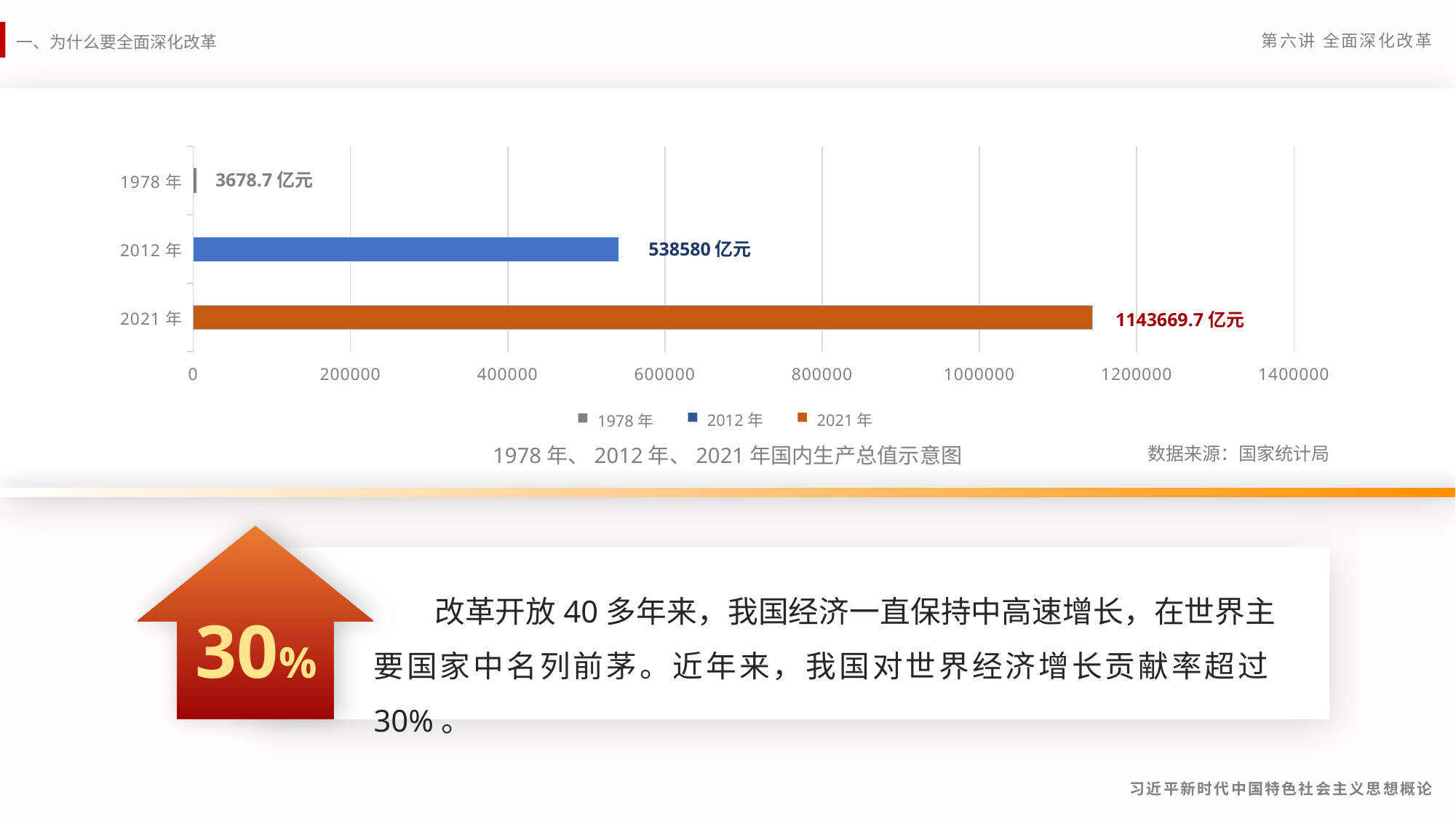
What is the value shown for 2012 年? 538580 亿元 Which year has the lowest value? 1978 年 How many categories (years) are shown in the chart? 3 What is the difference between the values for 2012 年 and 1978 年? 534901.3 亿元 What is the value shown for 2021 年? 1143669.7 亿元 Which year has the highest value? 2021 年 What is the value shown for 1978 年? 3678.7 亿元 Is the value for 2012 年 greater or less than 600000? less What is the data source stated below the chart? 国家统计局 What kind of chart is shown on the slide? bar chart Which is larger, the value for 2012 年 or the value for 2021 年? 2021 年 What is the difference between the values for 2021 年 and 2012 年? 605089.7 亿元